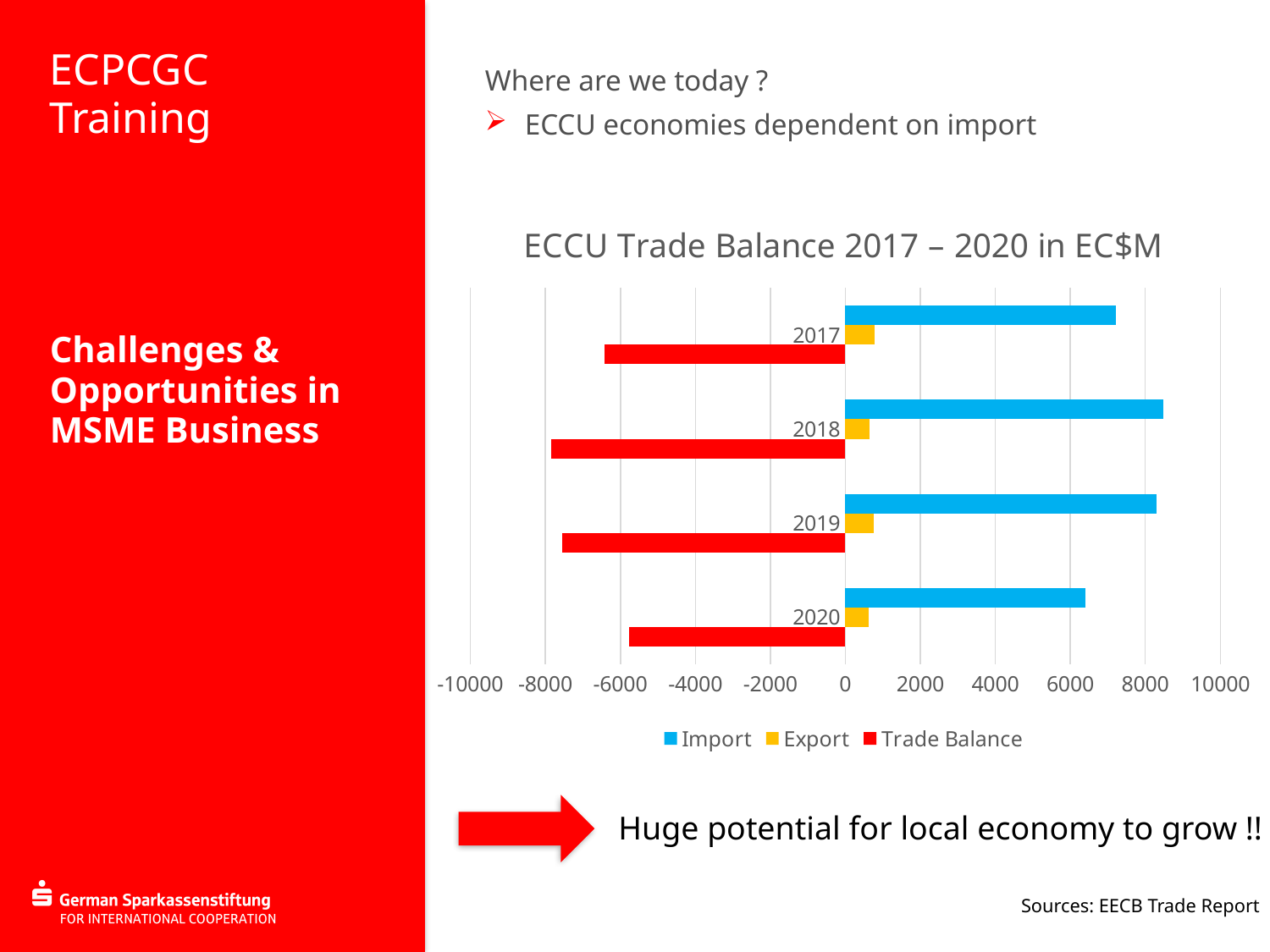
How many series does the legend list? 3 Is the Trade Balance value for 2018 greater or less than -6000? less Is the Import value for 2017 greater or less than 6000? greater What kind of chart is shown on the slide? bar chart Which is larger, the Import value for 2017 or for 2020? 2017 Is the Export value for 2019 greater or less than 2000? less How many years are shown on the chart? 4 What is the title of the chart? ECCU Trade Balance 2017 – 2020 in EC$M Which series is shown in red? Trade Balance Which year has the lowest Import value? 2020